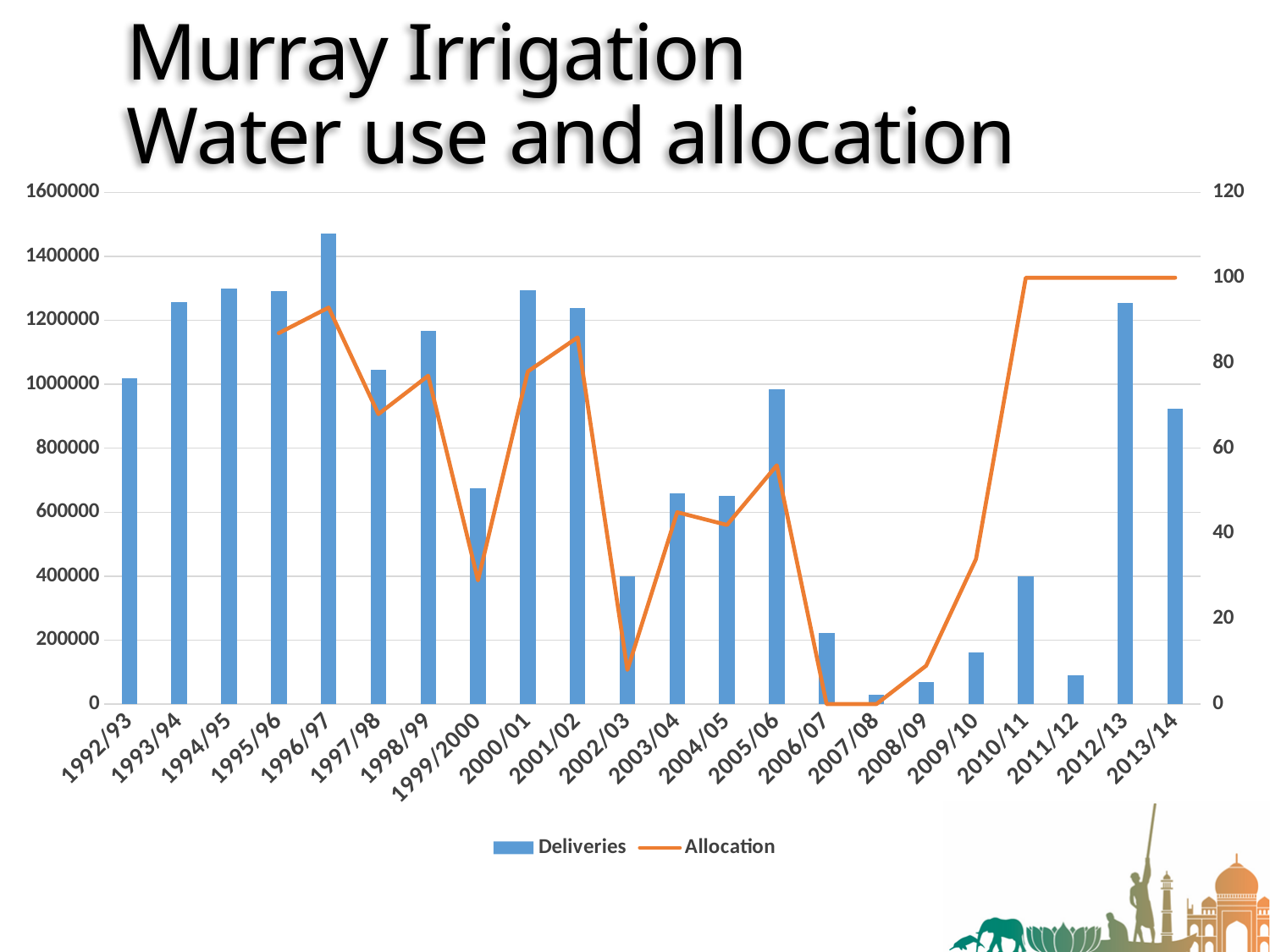
Is the Allocation value for 1996/97 greater or less than 80? greater Is the Deliveries value for 1993/94 greater or less than 1200000? greater Is the Allocation value for 2002/03 greater or less than 20? less Which year has the highest Deliveries value? 1996/97 How many series does the legend list? 2 Which year has the lowest Deliveries value? 2007/08 Which year has the larger Deliveries value, 1996/97 or 2000/01? 1996/97 Which year has the larger Deliveries value, 1997/98 or 1998/99? 1998/99 How many years are shown on the x axis? 22 Does the Allocation line rise or fall from 2007/08 to 2010/11? rise